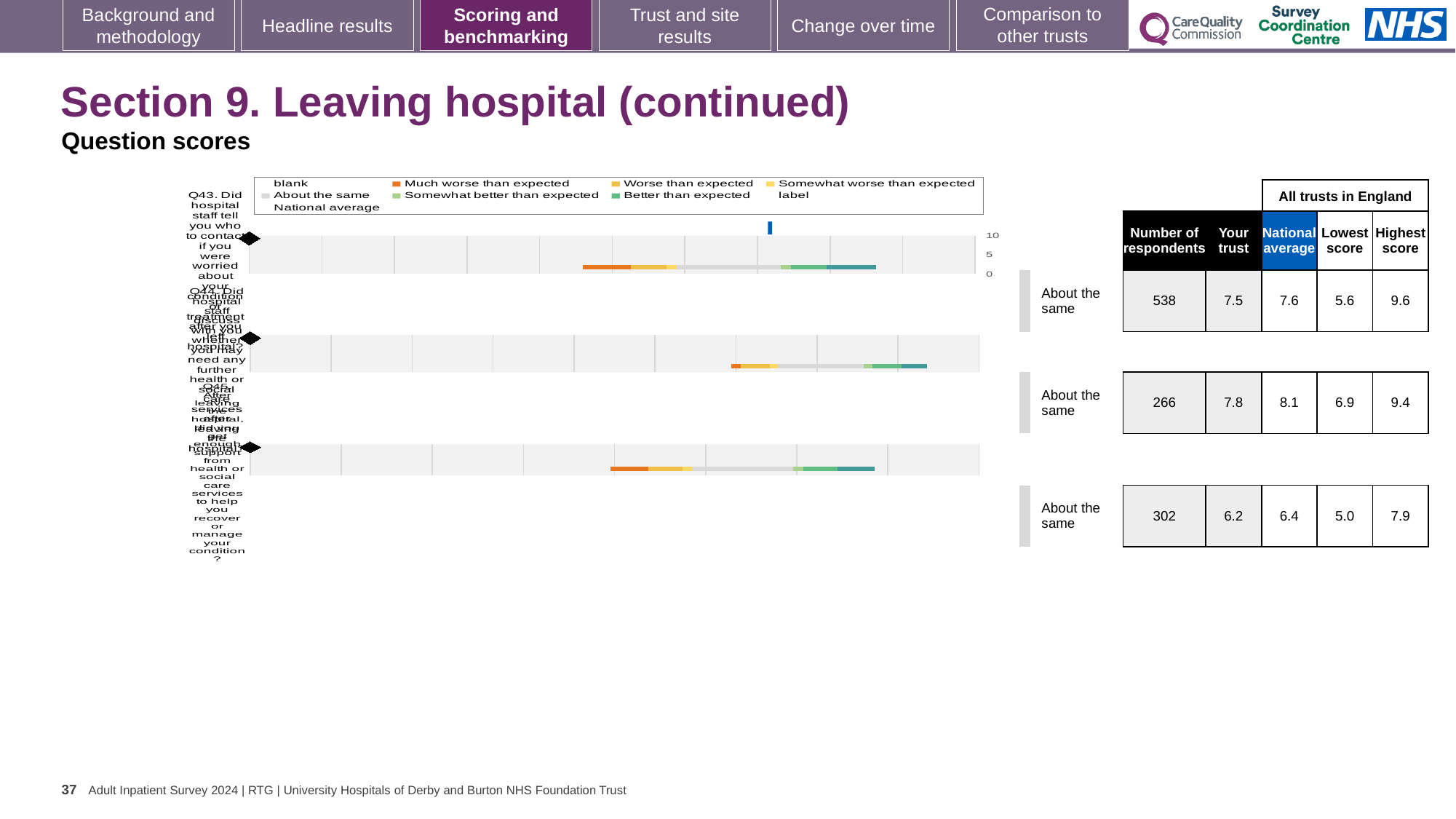
How many question charts are shown on the slide? 3 For the top chart (Q43), what is the 'Your trust' score? 7.5 Which of the three charts has the lowest 'Your trust' score? the bottom chart For the top chart (Q43), what is the national average score? 7.6 For the top chart (Q43), how many respondents are there? 538 What kind of chart is used to show the question scores on this slide? bar chart In the chart legend, which category is shown in orange? Much worse than expected For the bottom chart, what is the 'Your trust' score? 6.2 For the middle chart, what is the difference between the highest score and the lowest score across all trusts in England? 2.5 In the chart legend, which category is shown in dark green? Better than expected For the middle chart, what is the 'Your trust' score? 7.8 For the top chart (Q43), which is larger: the 'Your trust' score or the national average? National average